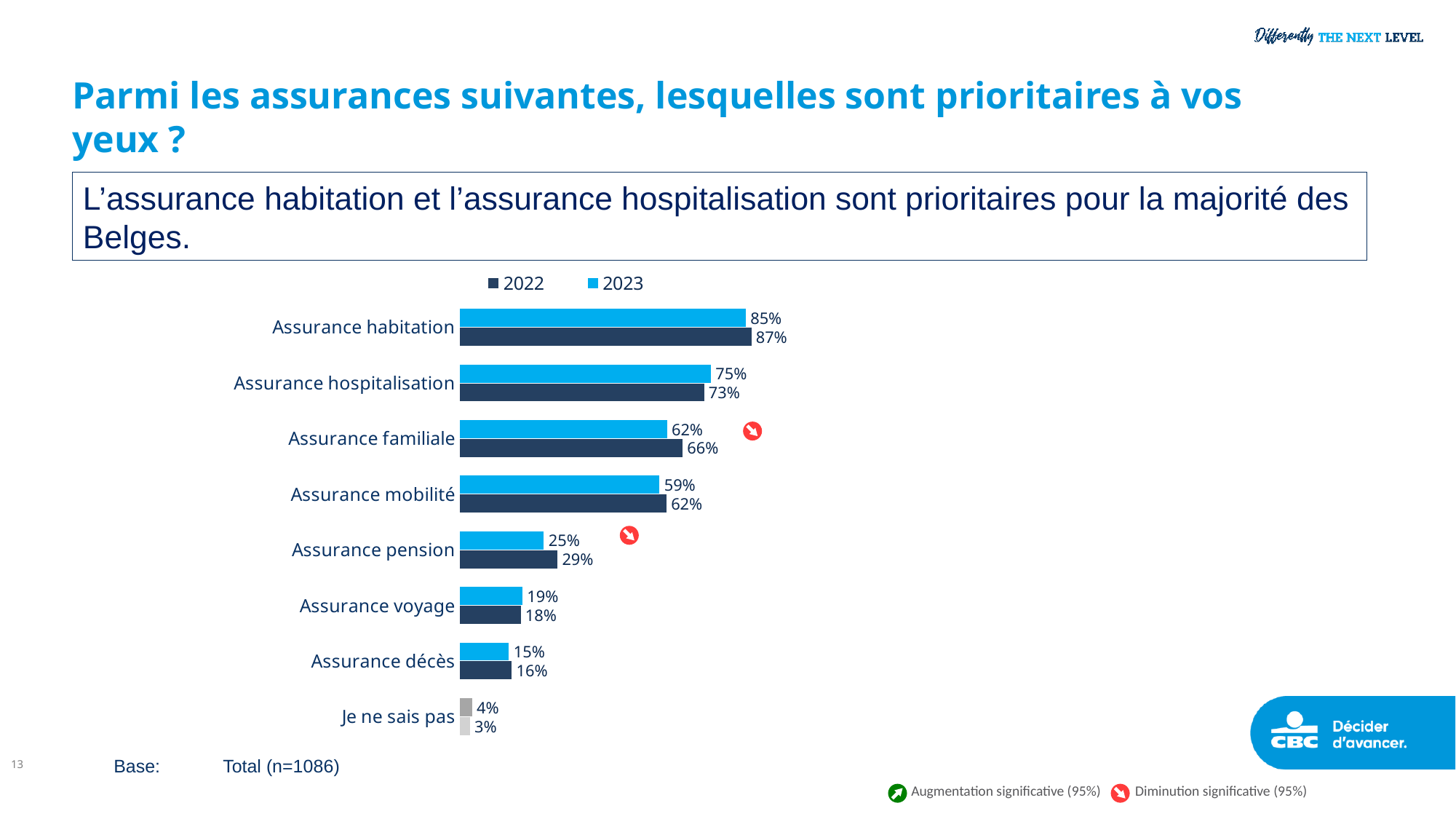
Which category has the highest 2022 value? Assurance habitation Which category has the lowest 2023 value? Je ne sais pas Which is larger for Assurance mobilité, the 2022 value or the 2023 value? 2022 What is the 2023 value for Assurance habitation? 85% What is the difference between the 2022 and 2023 values for Assurance familiale? 4% Which series is shown in dark navy in the legend? 2022 What type of chart is shown on the slide? Bar chart What is the 2023 value for Assurance pension? 25% How many categories are shown on the chart? 8 Which is larger for Assurance voyage, the 2022 value or the 2023 value? 2023 What is the 2022 value for Assurance hospitalisation? 73% How many series does the legend list? 2